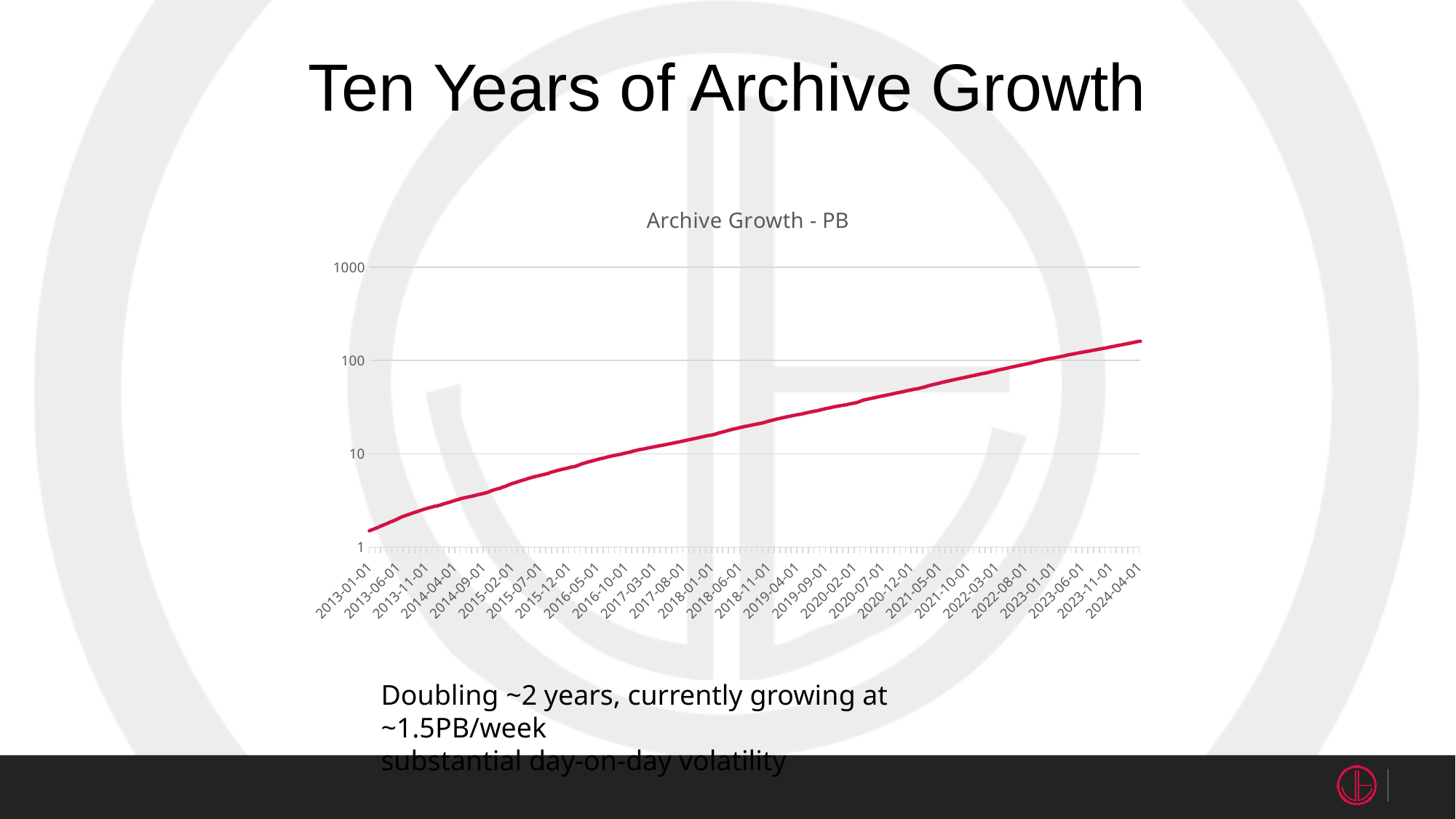
Is the value at 2013-01-01 greater or less than 10? less Is the value at 2019-09-01 greater or less than 100? less Is the value at 2015-02-01 greater or less than 10? less What is the title of the chart? Archive Growth - PB What colour is the plotted line? red What kind of chart is shown on the slide? line chart Do the values rise or fall along the x axis from 2013-01-01 to 2024-04-01? rise Which date on the x axis has the lowest value? 2013-01-01 Which date on the x axis has the highest value? 2024-04-01